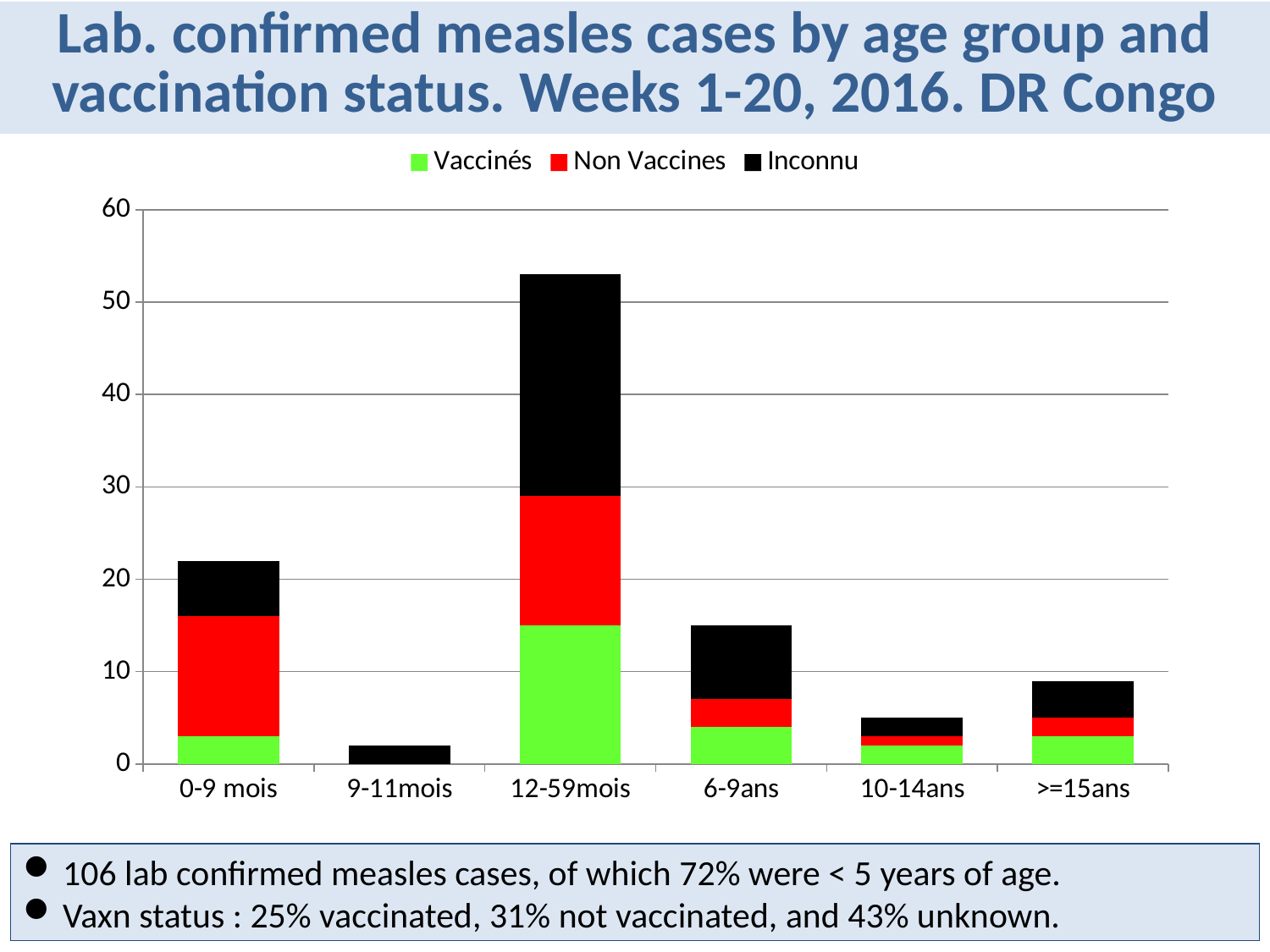
Is the total number of cases for 6-9ans greater or less than 20? less Which colour represents the Inconnu series in the legend? Black How many series does the legend list? 3 Is the total number of cases for 0-9 mois greater or less than 20? greater Is the total number of cases for 12-59mois greater or less than 50? greater Which age group has the lowest total number of lab confirmed measles cases? 9-11mois What kind of chart is shown on the slide? Stacked bar chart Which age group has more total cases, 0-9 mois or 6-9ans? 0-9 mois Which age group has the highest total number of lab confirmed measles cases? 12-59mois How many age-group categories are shown on the x axis? 6 Within the 12-59mois bar, which vaccination status series accounts for the largest segment? Inconnu